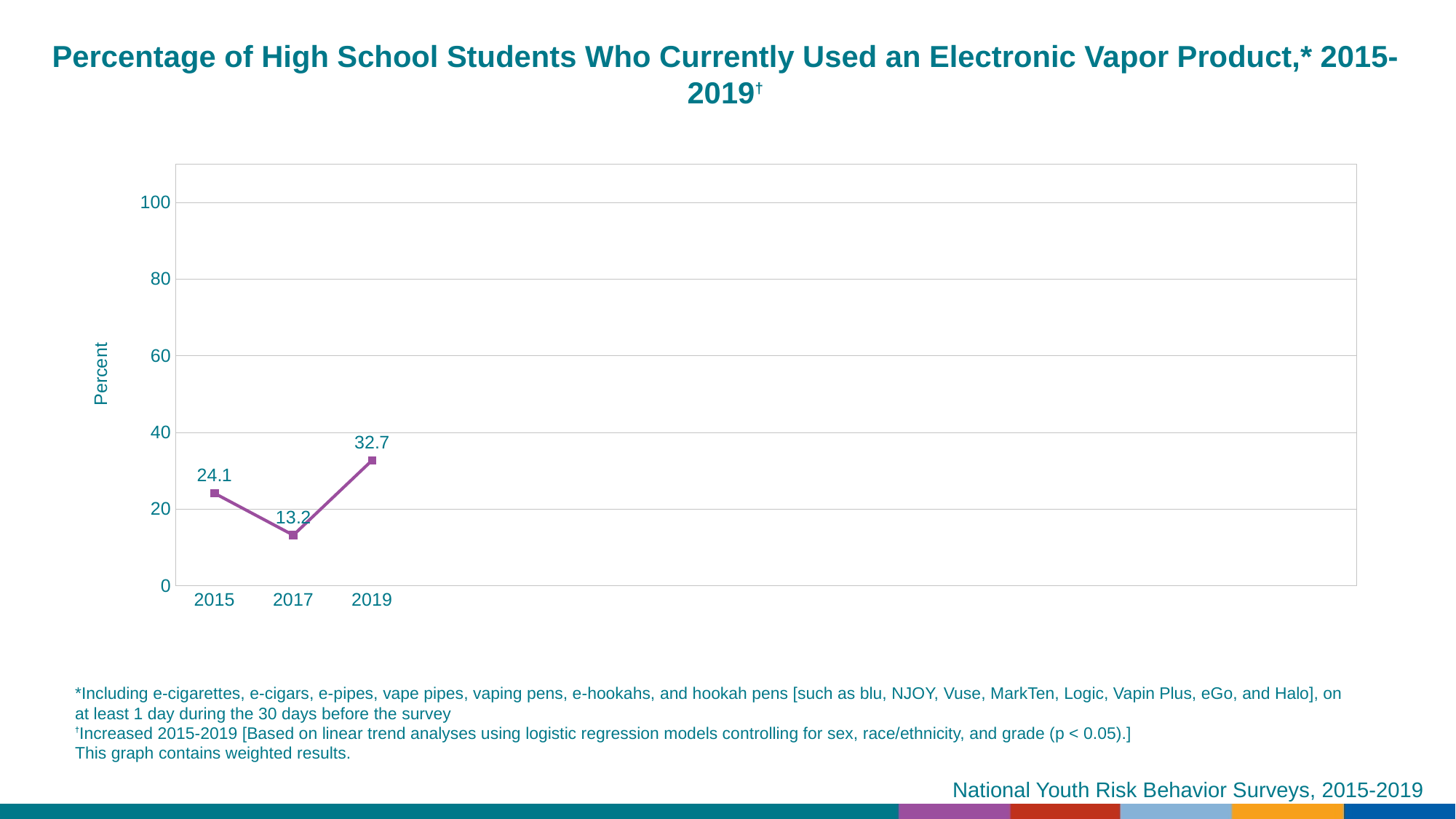
Which year has the lowest percentage of students who currently used an electronic vapor product? 2017 Is the value for 2019 greater or less than 40? less Which year has a larger value, 2015 or 2017? 2015 What is the difference between the 2019 and 2015 values? 8.6 What is the label of the y axis? Percent What is the difference between the 2015 and 2017 values? 10.9 What kind of chart is shown on the slide? line chart Which year has the highest percentage of students who currently used an electronic vapor product? 2019 What percentage of high school students currently used an electronic vapor product in 2015? 24.1 What percentage of high school students currently used an electronic vapor product in 2017? 13.2 How many years are plotted on the chart? 3 What percentage of high school students currently used an electronic vapor product in 2019? 32.7